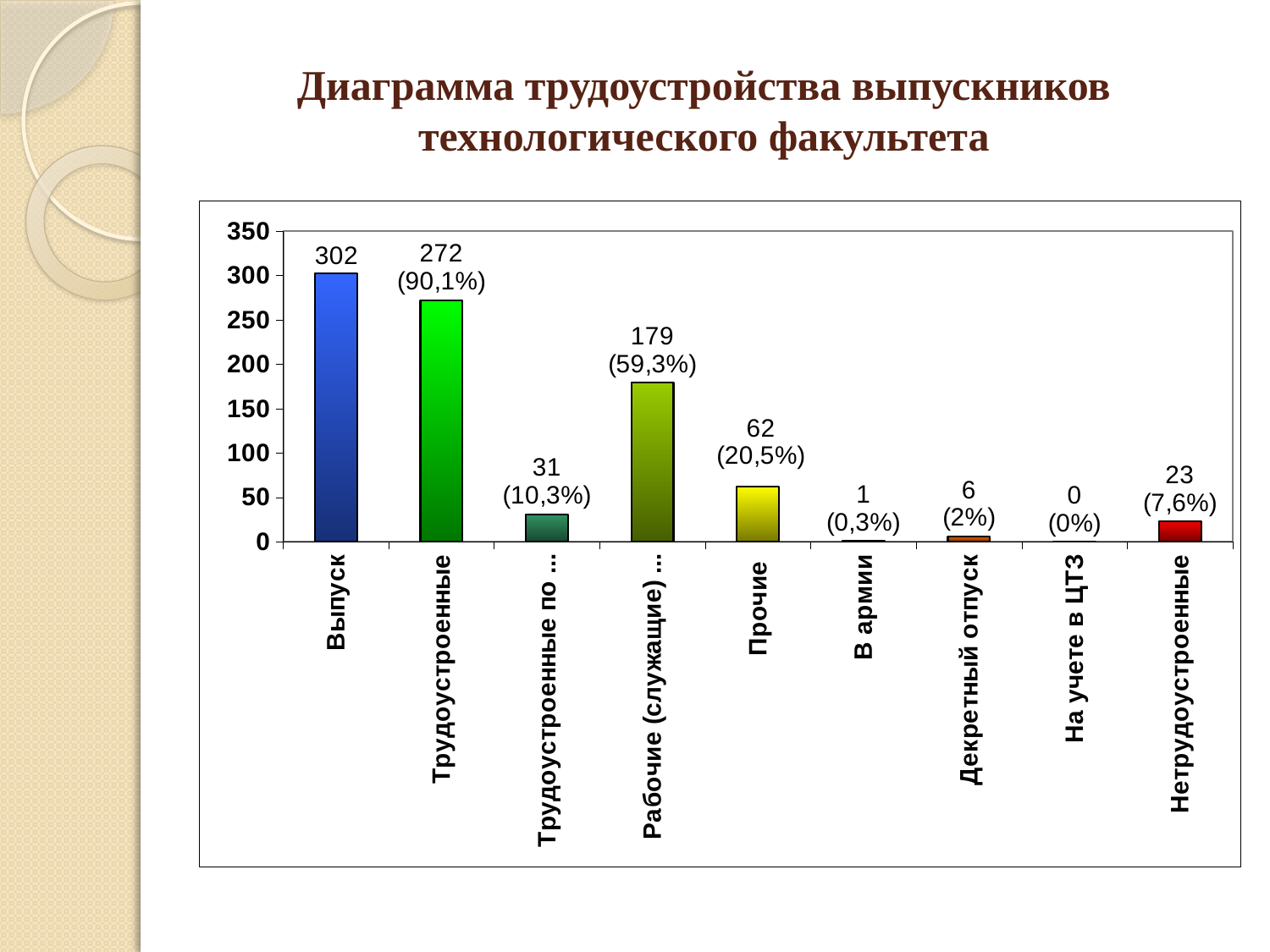
What kind of chart is shown on the slide? bar chart What is the value for Декретный отпуск? 6 What is the value for Трудоустроенные? 272 How many categories are shown on the x axis? 9 Which category has the highest value? Выпуск What is the value for Нетрудоустроенные? 23 Which category has the lowest value? На учете в ЦТЗ Which is larger, the value for Прочие or the value for Нетрудоустроенные? Прочие What is the title of the slide? Диаграмма трудоустройства выпускников технологического факультета What is the value for Выпуск? 302 What percentage is shown for Прочие? 20,5% What is the difference between the values for Выпуск and Трудоустроенные? 30